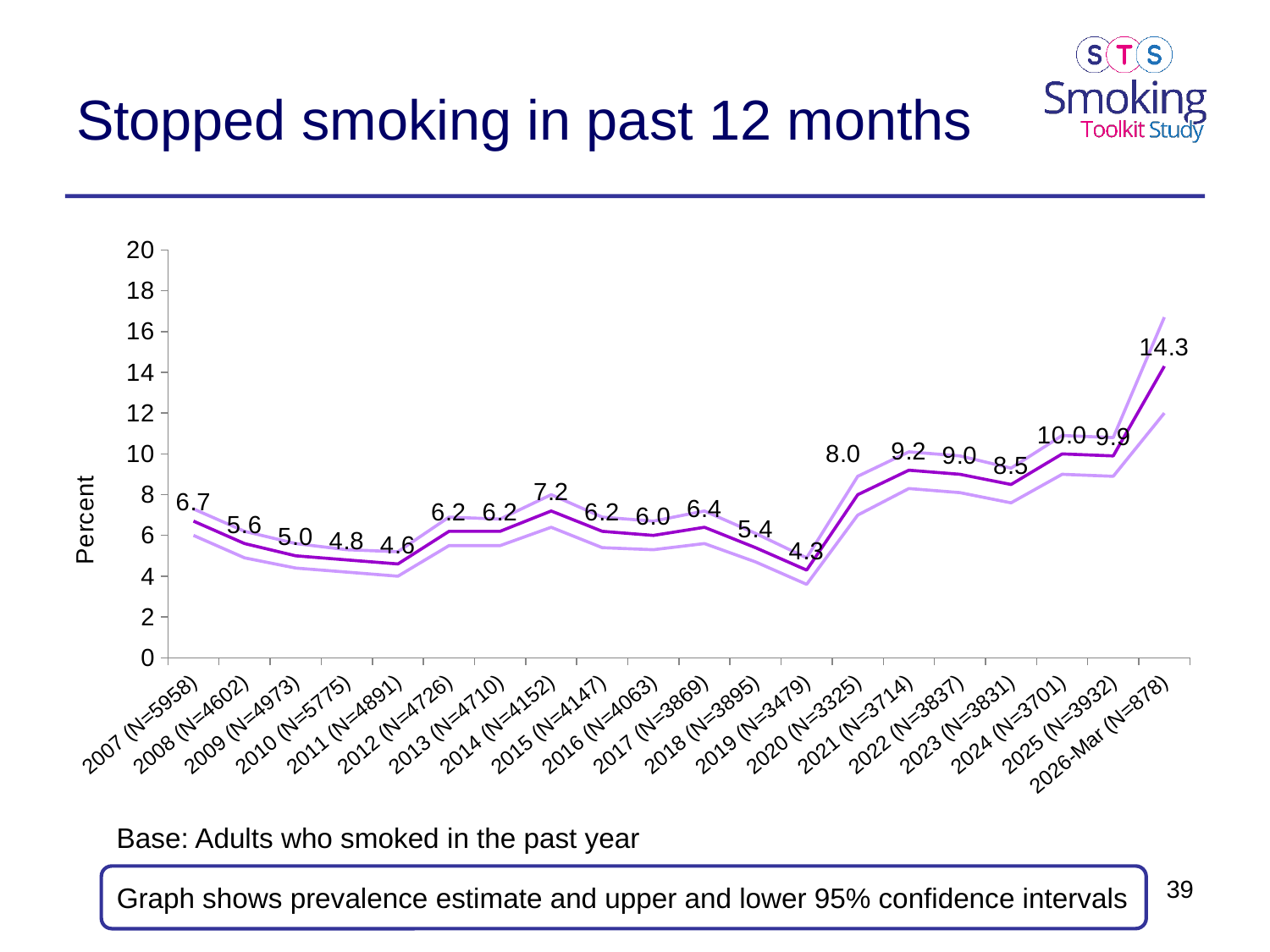
What is the difference between the values for 2026-Mar (N=878) and 2025 (N=3932)? 4.4 Is the value for 2024 (N=3701) greater or less than 8? greater How many years are plotted on the x axis? 20 Do the values rise or fall from 2019 (N=3479) to 2021 (N=3714)? Rise What is the value for 2026-Mar (N=878)? 14.3 What kind of chart is shown on the slide? Line chart What is the value for 2007 (N=5958)? 6.7 Which is larger, the value for 2014 (N=4152) or the value for 2011 (N=4891)? 2014 (N=4152) Which year has the highest value? 2026-Mar (N=878) What is the value for 2020 (N=3325)? 8.0 Which year has the lowest value? 2019 (N=3479) What is the label on the y axis? Percent